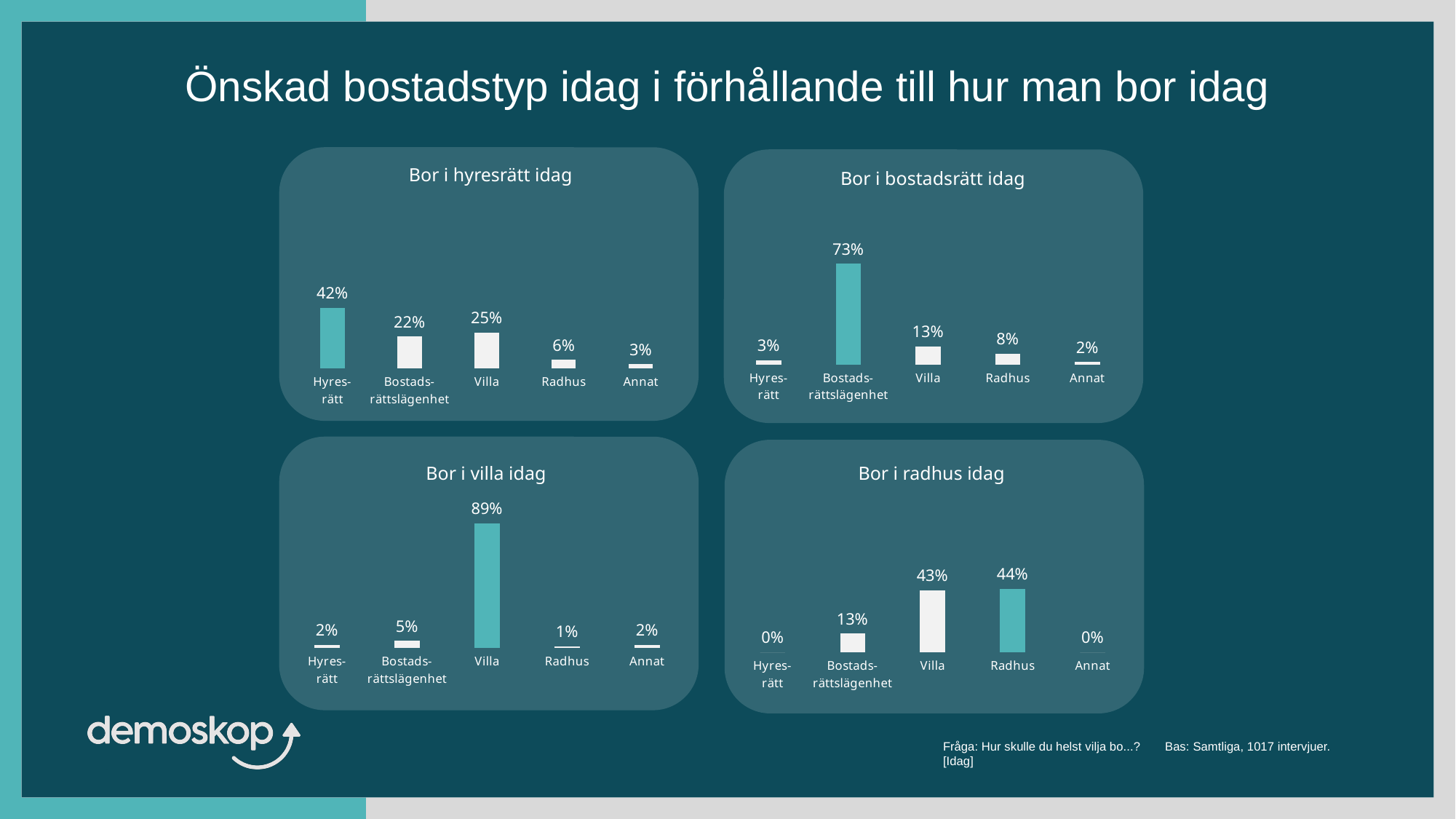
In the 'Bor i radhus idag' chart, what is the difference between the values for Radhus and Villa? 1% In the 'Bor i radhus idag' chart, what is the value for Bostadsrättslägenhet? 13% In the 'Bor i villa idag' chart, what is the value for Radhus? 1% What kind of chart is 'Bor i bostadsrätt idag'? Bar chart In the 'Bor i bostadsrätt idag' chart, what is the value for Bostadsrättslägenhet? 73% In the 'Bor i hyresrätt idag' chart, what is the difference between the values for Villa and Bostadsrättslägenhet? 3% How many charts are shown on the slide? 4 In the 'Bor i hyresrätt idag' chart, which category has the lowest value? Annat In the 'Bor i bostadsrätt idag' chart, which is larger, the value for Villa or the value for Radhus? Villa In the 'Bor i hyresrätt idag' chart, what is the value for Hyresrätt? 42% How many categories are shown in the 'Bor i villa idag' chart? 5 In the 'Bor i villa idag' chart, which category has the highest value? Villa